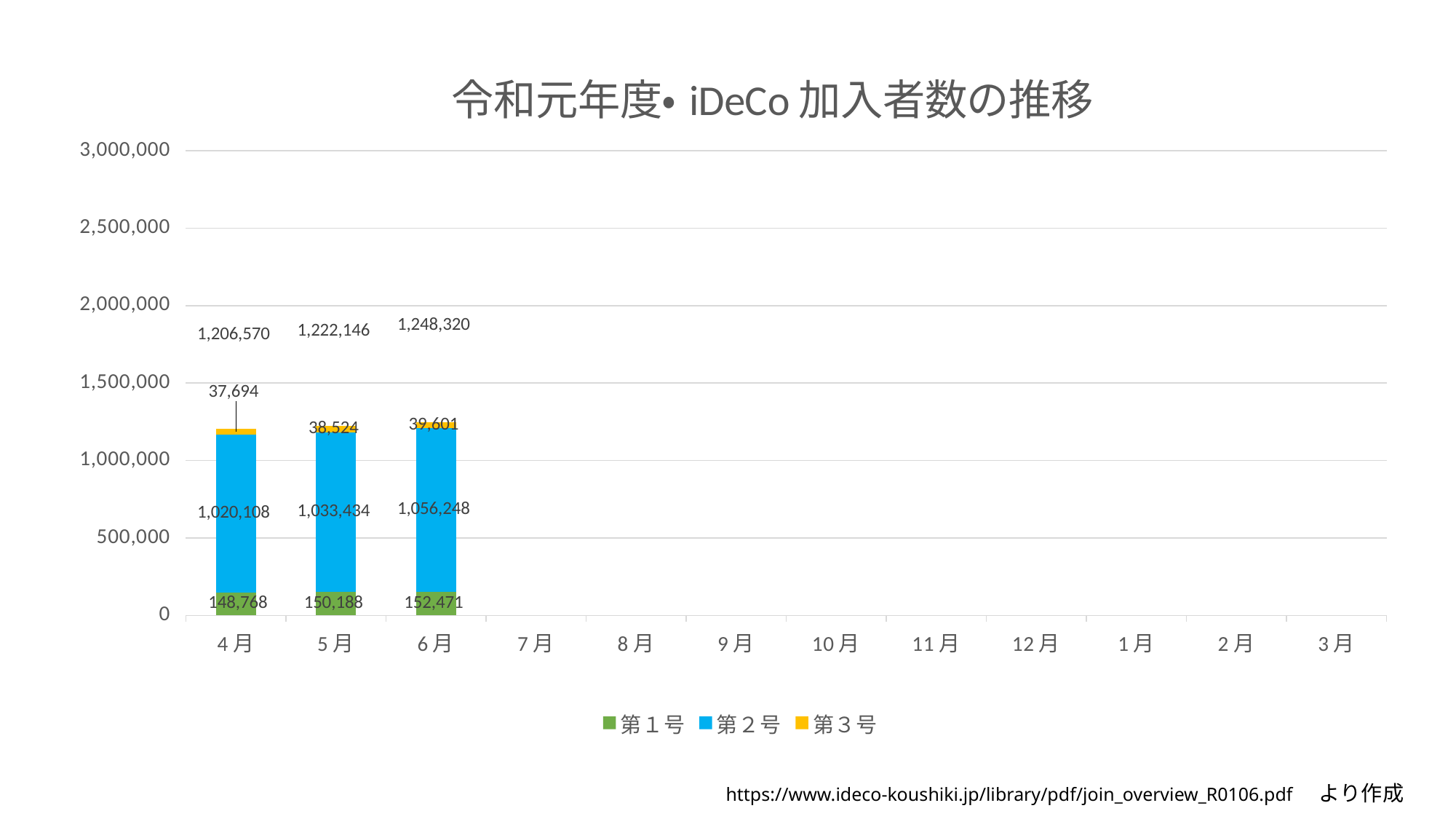
How many month categories are shown on the x axis? 12 What is the difference between the 第２号 values for 6月 and 4月? 36,140 What is the value for 第３号 in 5月? 38,524 What is the total of the stacked bar for 6月? 1,248,320 Which month has the highest total among the plotted bars? 6月 How many series does the legend list? 3 What is the value for 第１号 in 6月? 152,471 Do the stacked bar totals rise or fall from 4月 to 6月? Rise What type of chart is shown on the slide? Stacked bar chart What is the value for 第２号 in 4月? 1,020,108 Which series is shown in blue in the legend? 第２号 What is the total of the stacked bar for 4月? 1,206,570